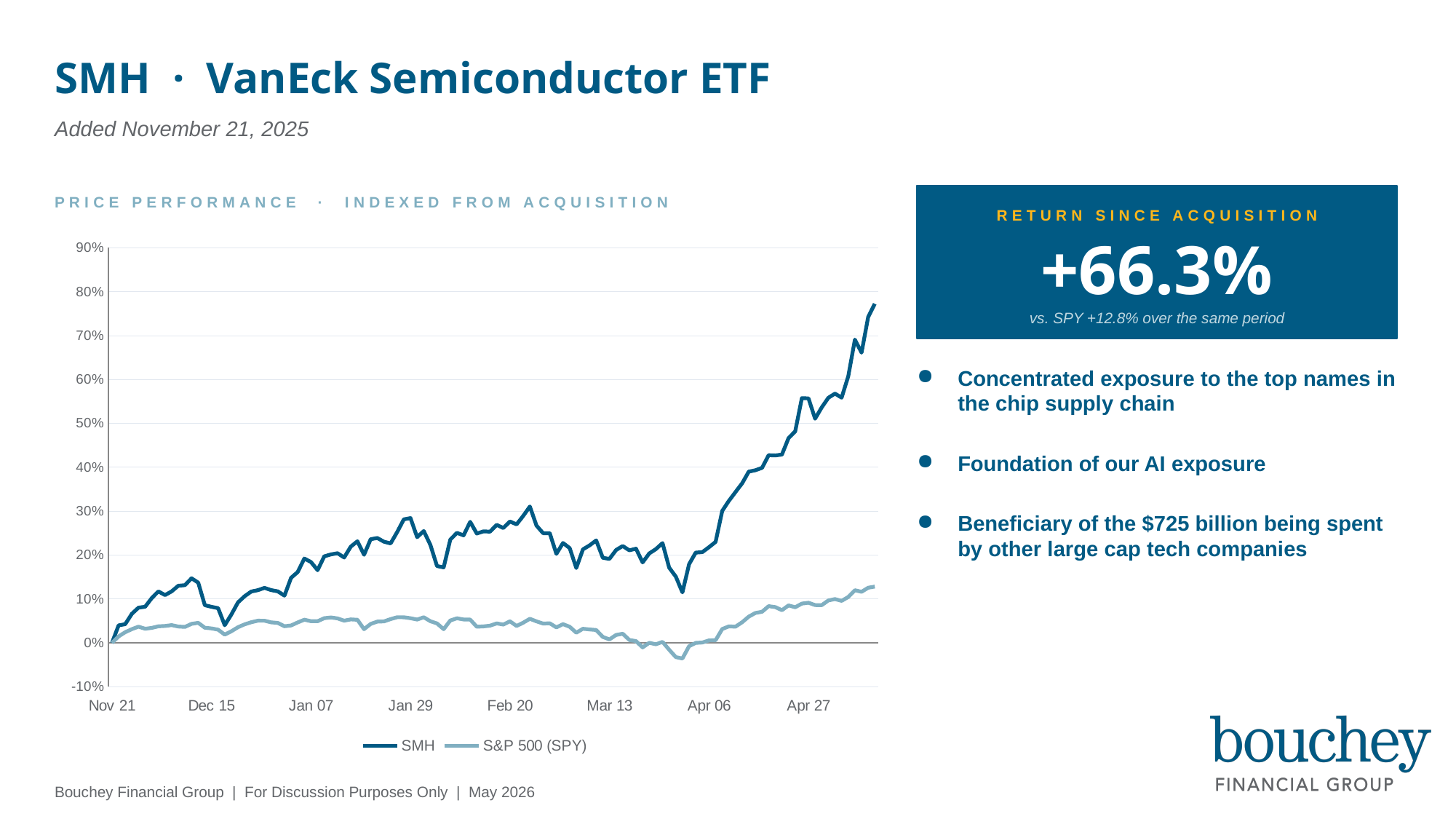
How many series does the chart legend list? 2 Is the value of the SMH line at the right end of the chart greater or less than 70%? greater What kind of chart is shown on the slide? line chart Is the value of the S&P 500 (SPY) line at the right end of the chart greater or less than 10%? greater Which series is higher at the right end of the chart, SMH or S&P 500 (SPY)? SMH What are the two series named in the chart legend? SMH and S&P 500 (SPY) Does the SMH line overall rise or fall from Nov 21 to the end of the chart? rise Is the lowest point of the S&P 500 (SPY) line, shortly before Apr 06, greater or less than 0%? less What is the title of the chart? PRICE PERFORMANCE · INDEXED FROM ACQUISITION According to the callout box, what is SMH's return since acquisition? +66.3% How many date labels are shown on the x axis of the chart? 8 According to the callout box, what is SPY's return over the same period? +12.8%